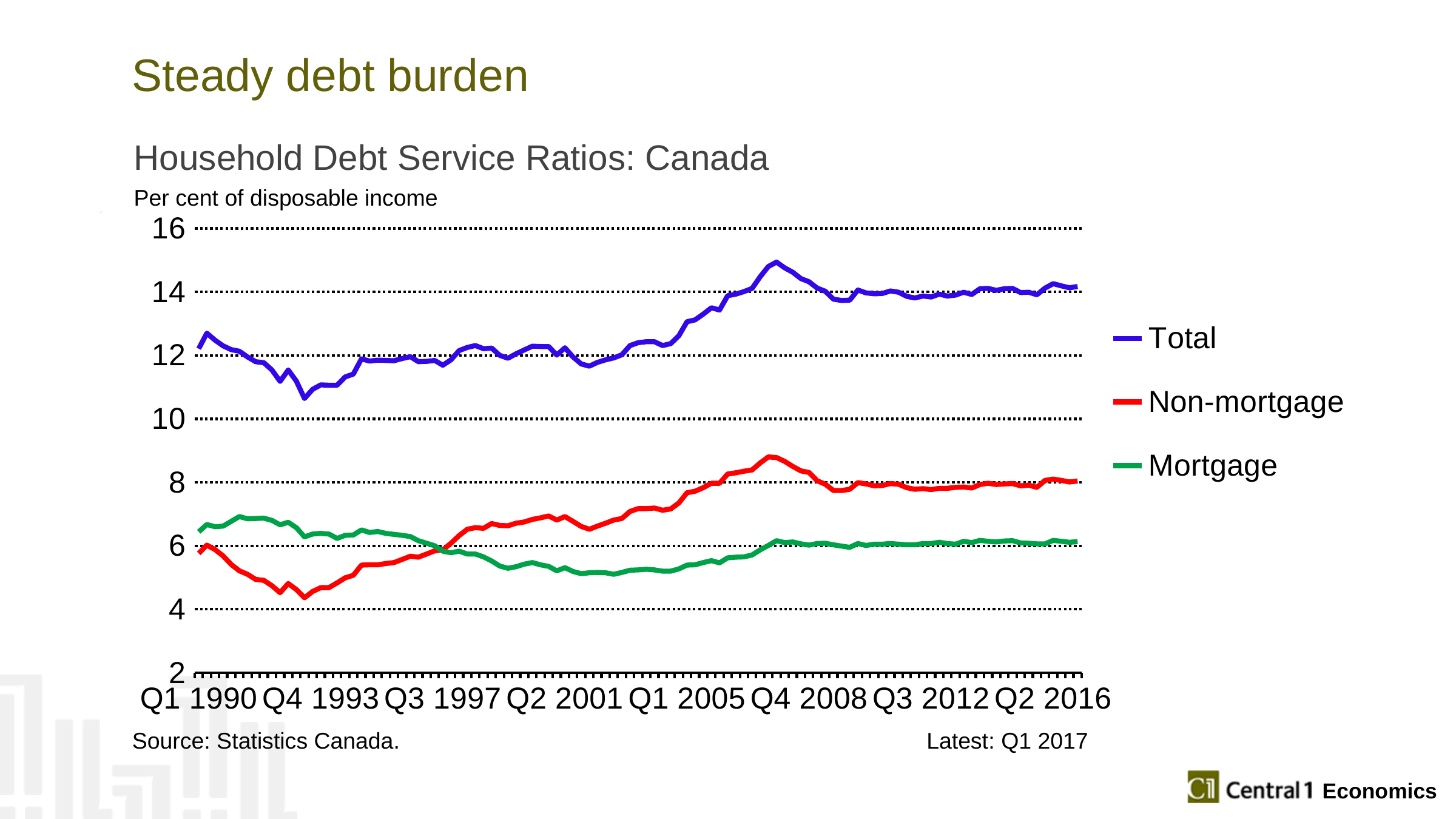
How many series does the legend list? 3 Is the peak value of the Total series around Q4 2008 greater or less than 14? greater Is the lowest value of the Non-mortgage series, reached in the early 1990s, greater or less than 6? less What kind of chart is shown on the slide? Line chart Is the lowest value of the Total series, reached in the early 1990s, greater or less than 12? less Does the Mortgage series rise or fall between Q1 1990 and Q2 2001? fall What is the title of the chart? Household Debt Service Ratios: Canada Does the Total series rise or fall between Q1 2005 and Q4 2008? rise What unit is shown on the vertical axis of the chart? Per cent of disposable income At Q2 2016, which series is larger: Non-mortgage or Mortgage? Non-mortgage